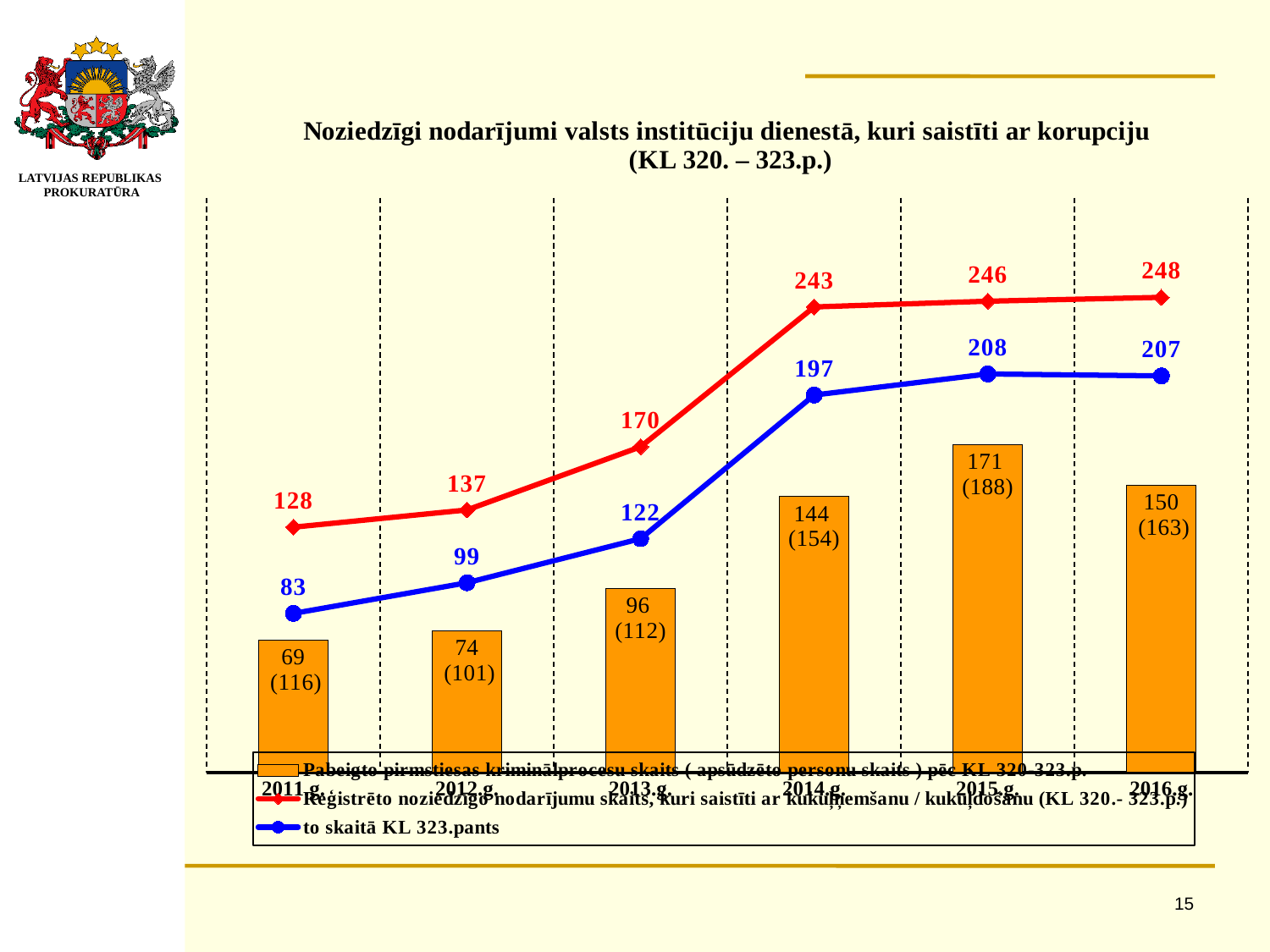
What is the difference between the red line value and the blue line value in 2013.g.? 48 Does the red line rise or fall from 2011.g. to 2016.g.? Rise What is the value of the blue line (to skaitā KL 323.pants) for 2012.g.? 99 In which year is the blue line at its lowest value? 2011.g. How many series does the legend list? 3 Which is larger: the blue line value in 2015.g. or in 2016.g.? 2015.g. How many years are shown on the x axis? 6 What is the bar label for 2015.g.? 171 (188) What kind of chart is this? Combined bar and line chart What colour is the line for 'to skaitā KL 323.pants'? Blue What is the value of the red line (Reģistrēto noziedzīgo nodarījumu skaits) for 2014.g.? 243 In which year does the red line reach its highest value? 2016.g.